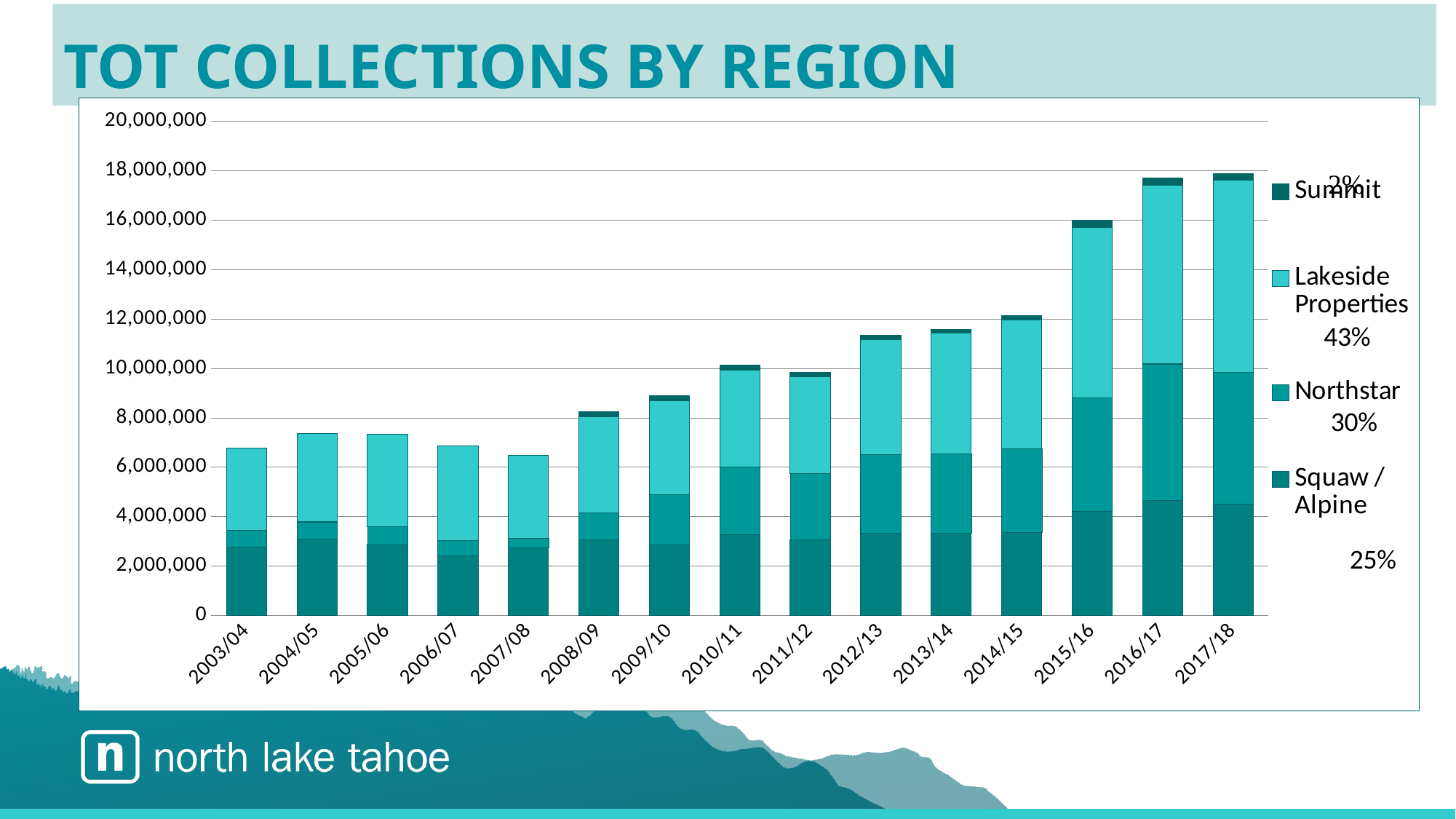
Is the total TOT collection for 2017/18 greater or less than 16,000,000? greater Which year has the larger total TOT collection, 2008/09 or 2007/08? 2008/09 How many fiscal years are shown along the x axis? 15 Is the total TOT collection for 2003/04 greater or less than 6,000,000? greater How many series does the legend list? 4 What kind of chart is shown on the slide? Stacked bar chart Is the total TOT collection for 2012/13 greater or less than 10,000,000? greater Which year has the larger total TOT collection, 2014/15 or 2015/16? 2015/16 Which series is listed at the bottom of the legend? Squaw / Alpine Do total TOT collections generally rise or fall from 2003/04 to 2017/18? rise What is the title of the chart? TOT COLLECTIONS BY REGION